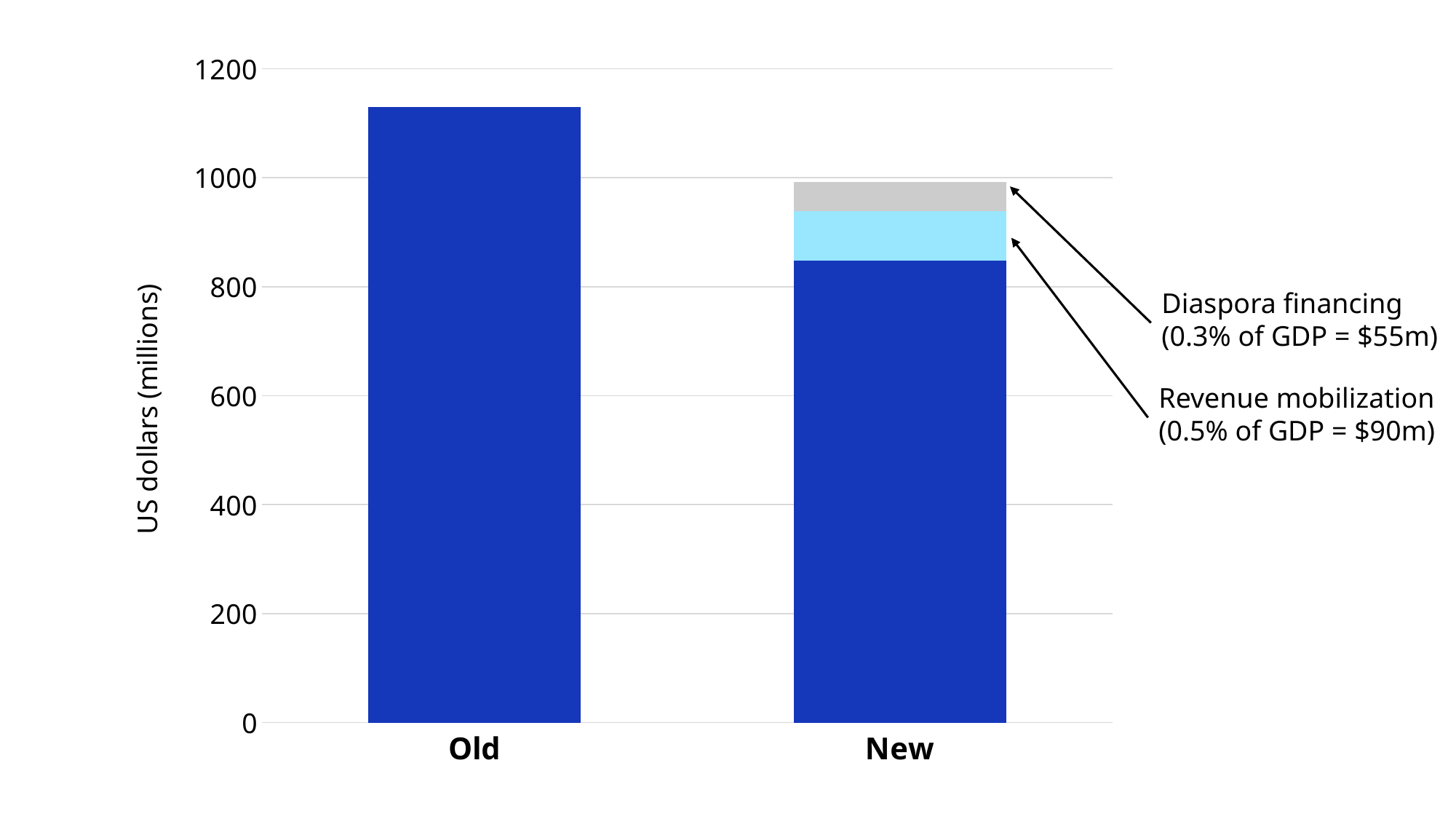
According to the annotation, how much is Diaspora financing in the New bar? $55m Is the dark blue segment of the New bar greater or less than 800? greater What kind of chart is shown on the slide? bar chart Which category has the lowest total bar height? New Which category has the taller bar, Old or New? Old What percentage of GDP does the annotation give for Revenue mobilization? 0.5% How much larger is Revenue mobilization than Diaspora financing in the New bar? $35m Is the value for Old greater or less than 1000? greater How many categories are shown on the x axis? 2 What is the label on the y axis? US dollars (millions) According to the annotation, how much is Revenue mobilization in the New bar? $90m